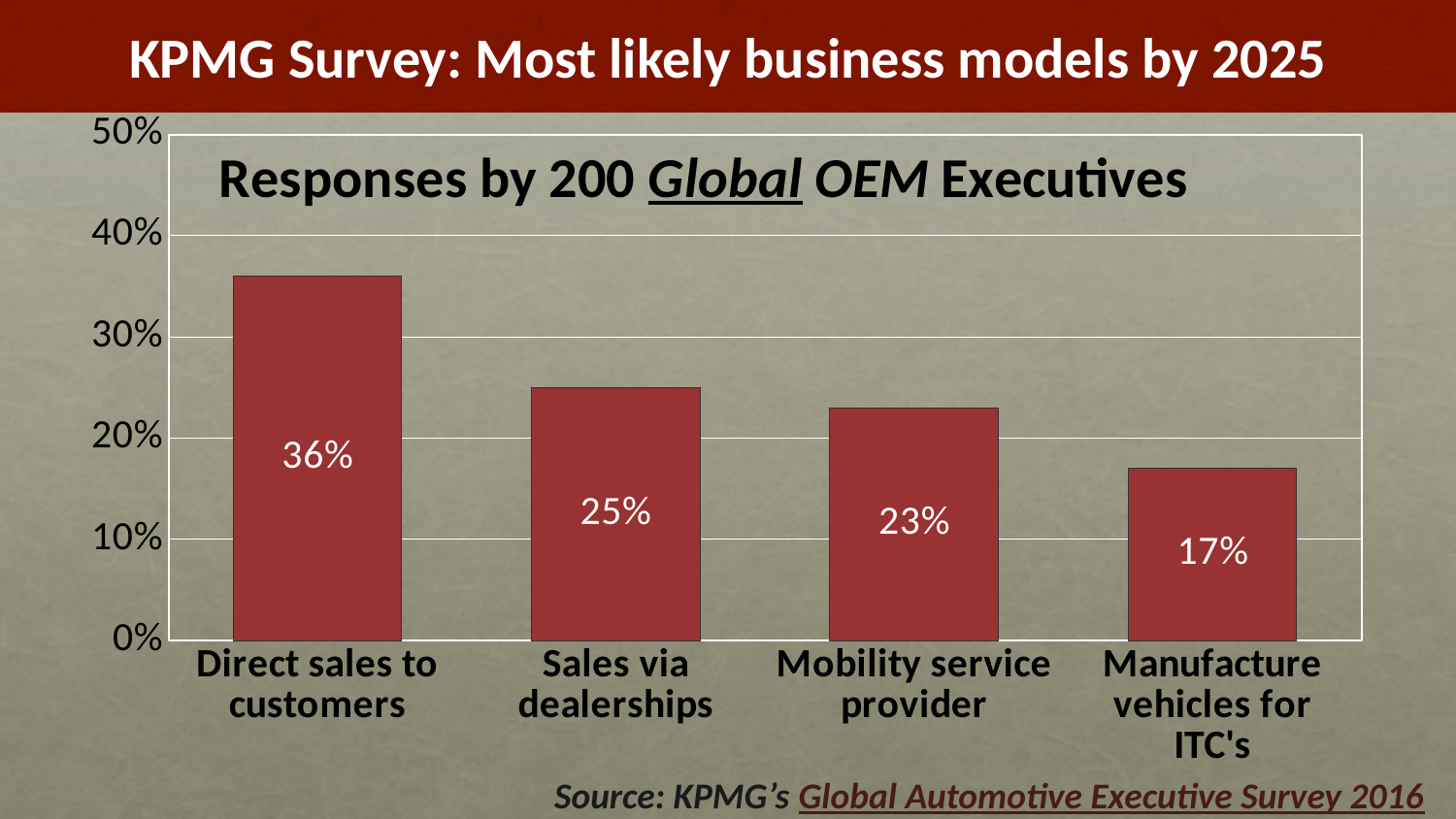
What is the title shown inside the chart area? Responses by 200 Global OEM Executives What kind of chart is shown on the slide? Bar chart What percentage of respondents chose 'Direct sales to customers'? 36% Which business model has the highest percentage? Direct sales to customers What is the value for 'Sales via dealerships'? 25% What is the value for 'Mobility service provider'? 23% What is the value for 'Manufacture vehicles for ITC's'? 17% Which is larger: 'Mobility service provider' or 'Manufacture vehicles for ITC's'? Mobility service provider Is the value for 'Direct sales to customers' greater or less than 30%? greater How many business models are shown in the chart? 4 What is the difference between 'Direct sales to customers' and 'Sales via dealerships'? 11% Which business model has the lowest percentage? Manufacture vehicles for ITC's